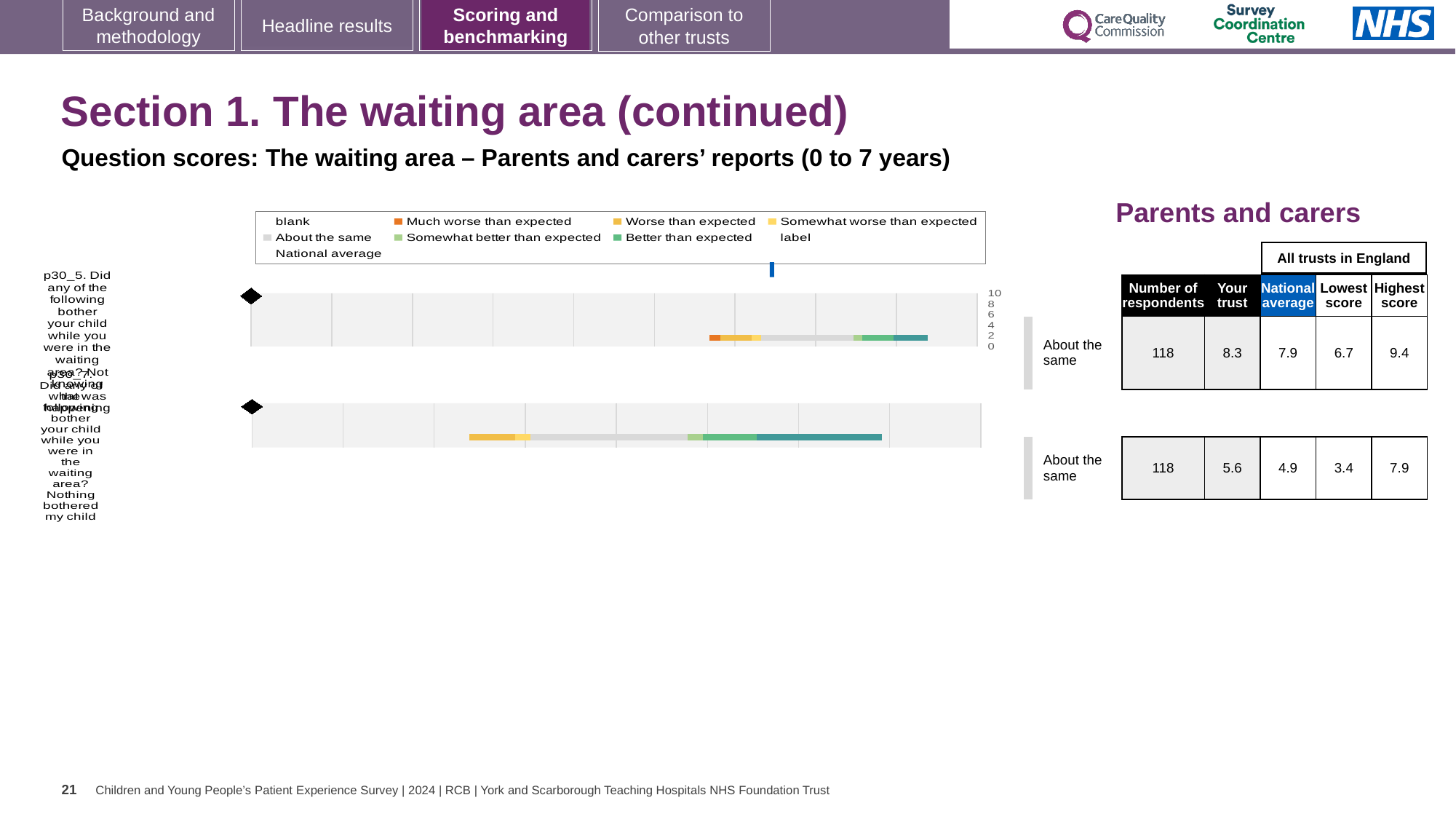
For the bottom chart (p30_7), what is the difference between the highest and lowest scores in the table? 4.5 For the bottom chart (p30_7, Nothing bothered my child), what is the 'Your trust' score shown in the table beside it? 5.6 How many entries does the chart legend list? 9 For the bottom chart (p30_7), what is the lowest score among all trusts in England shown in the table? 3.4 How many question rows (bar charts) are shown on the slide? 2 Which has the larger 'Your trust' score in the table: the top chart (p30_5) or the bottom chart (p30_7)? the top chart (p30_5) How many respondents are listed in the table for the top chart (p30_5)? 118 What benchmark category label is shown to the right of both charts? About the same For the top chart (p30_5), what is the national average score shown in the table beside it? 7.9 For the top chart (p30_5, Not knowing what was happening), what is the 'Your trust' score shown in the table beside it? 8.3 For the top chart (p30_5), what is the difference between the 'Your trust' score and the national average in the table? 0.4 What kind of chart is used on this slide to show the question scores? bar chart